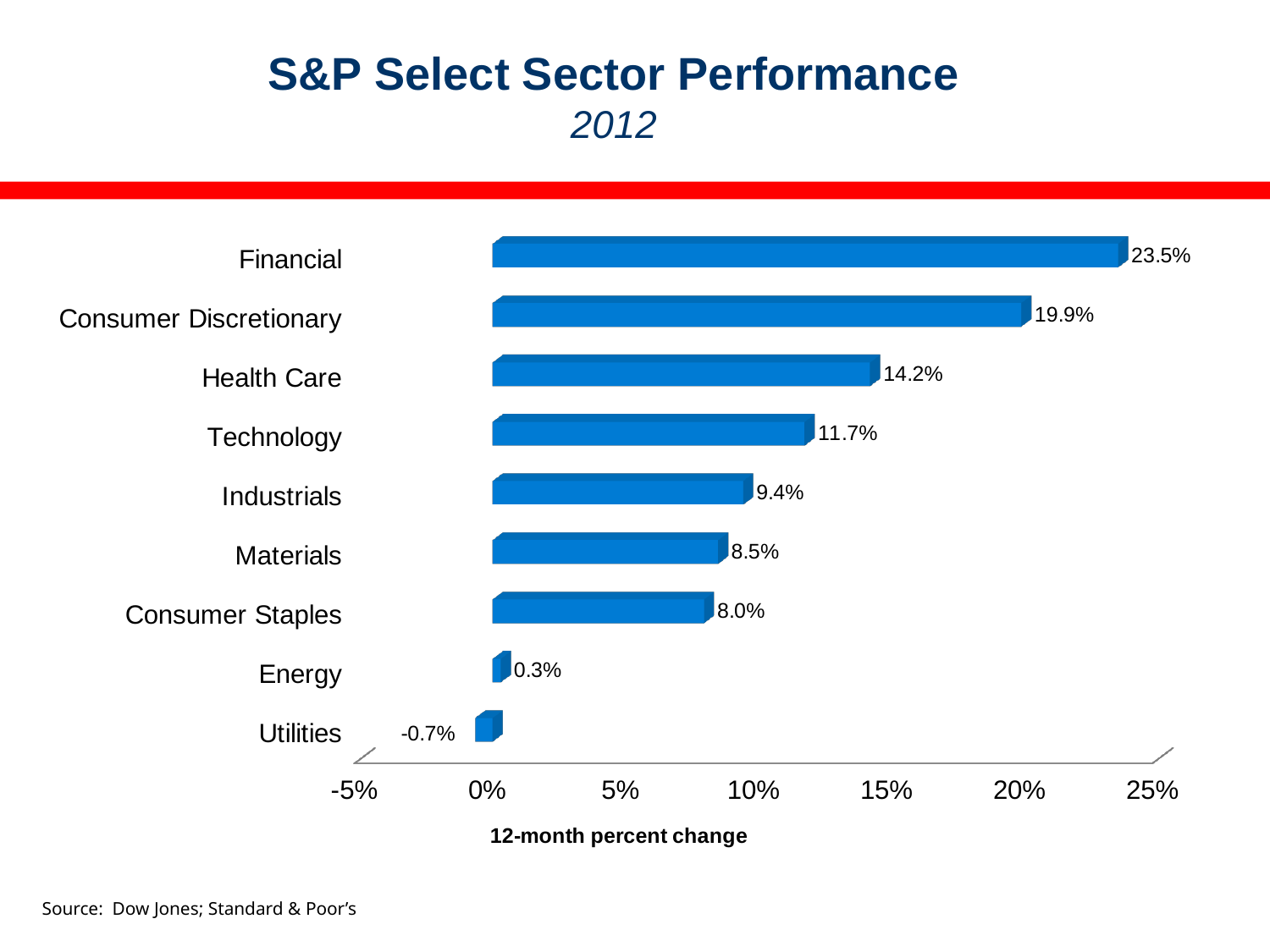
What is the 12-month percent change for Financial? 23.5% Which sector has the lowest 12-month percent change? Utilities What is the 12-month percent change for Utilities? -0.7% What is the 12-month percent change for Health Care? 14.2% What kind of chart is shown on the slide? Bar chart What is the label on the horizontal axis of the chart? 12-month percent change Which sector has the highest 12-month percent change? Financial What is the difference between the values for Industrials and Materials? 0.9% How many sectors are shown in the chart? 9 Is the value for Consumer Discretionary greater or less than 15%? greater Which is larger, the value for Technology or the value for Consumer Staples? Technology What is the difference between the values for Financial and Consumer Discretionary? 3.6%